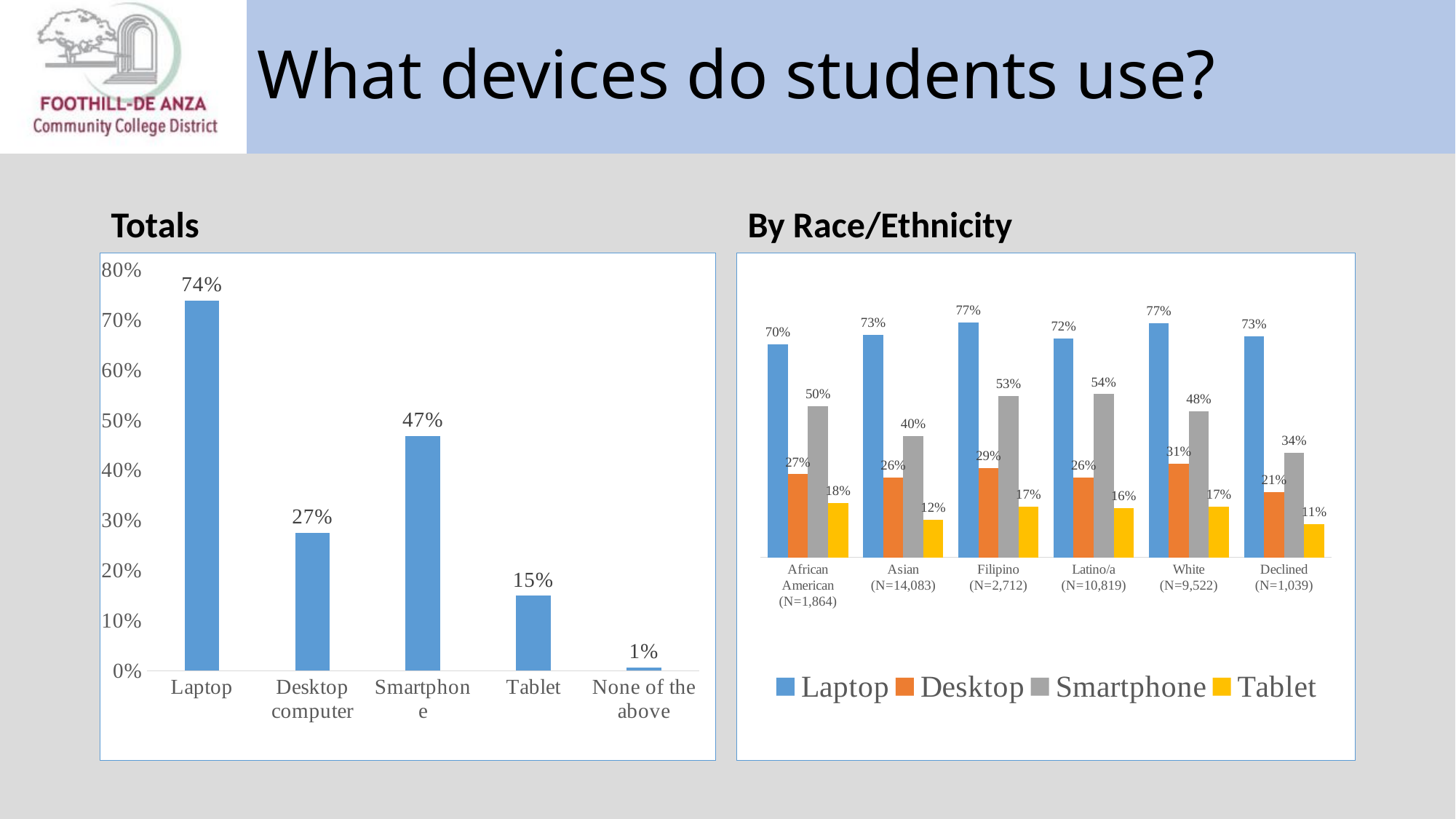
In the Totals chart, which device has the lowest value? None of the above In the Totals chart, what is the difference between the Laptop and Smartphone values? 27% In the By Race/Ethnicity chart, is the Laptop value for White students larger or the Laptop value for African American students? White In the By Race/Ethnicity chart, how many series does the legend list? 4 What kind of chart is the Totals chart? Bar chart In the By Race/Ethnicity chart, which group has the lowest Desktop value? Declined In the Totals chart, what percentage of students use a laptop? 74% In the Totals chart, how many categories are shown on the x axis? 5 In the By Race/Ethnicity chart, what is the Smartphone value for Latino/a students? 54% In the By Race/Ethnicity chart, what is the Tablet value for Declined? 11% In the By Race/Ethnicity chart, which group has the highest Smartphone value? Latino/a In the Totals chart, is the value for Tablet greater or less than 20%? less